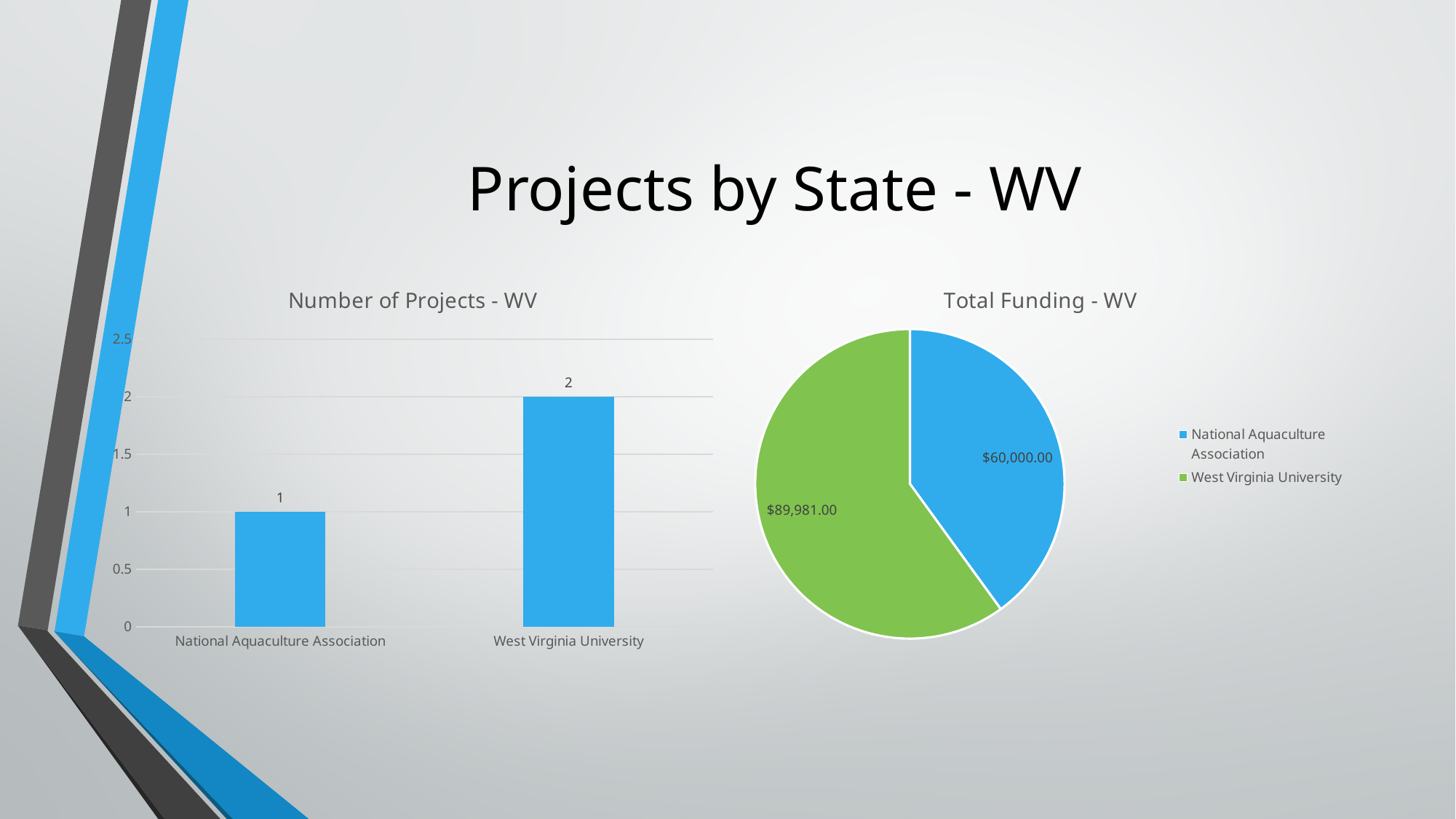
In the 'Total Funding - WV' chart, what colour is the West Virginia University slice? Green In the 'Number of Projects - WV' chart, how many categories are shown on the x axis? 2 In the 'Total Funding - WV' chart, what is the difference in funding between West Virginia University and the National Aquaculture Association? $29,981.00 What kind of chart is 'Total Funding - WV'? Pie chart In the 'Number of Projects - WV' chart, how many projects does the National Aquaculture Association have? 1 In the 'Number of Projects - WV' chart, what is the difference in number of projects between West Virginia University and the National Aquaculture Association? 1 In the 'Number of Projects - WV' chart, which organization has the most projects? West Virginia University In the 'Total Funding - WV' chart, what is the funding amount for West Virginia University? $89,981.00 In the 'Total Funding - WV' chart, what is the funding amount for the National Aquaculture Association? $60,000.00 In the 'Total Funding - WV' chart, which organization received more funding? West Virginia University In the 'Number of Projects - WV' chart, how many projects does West Virginia University have? 2 What kind of chart is 'Number of Projects - WV'? Bar chart